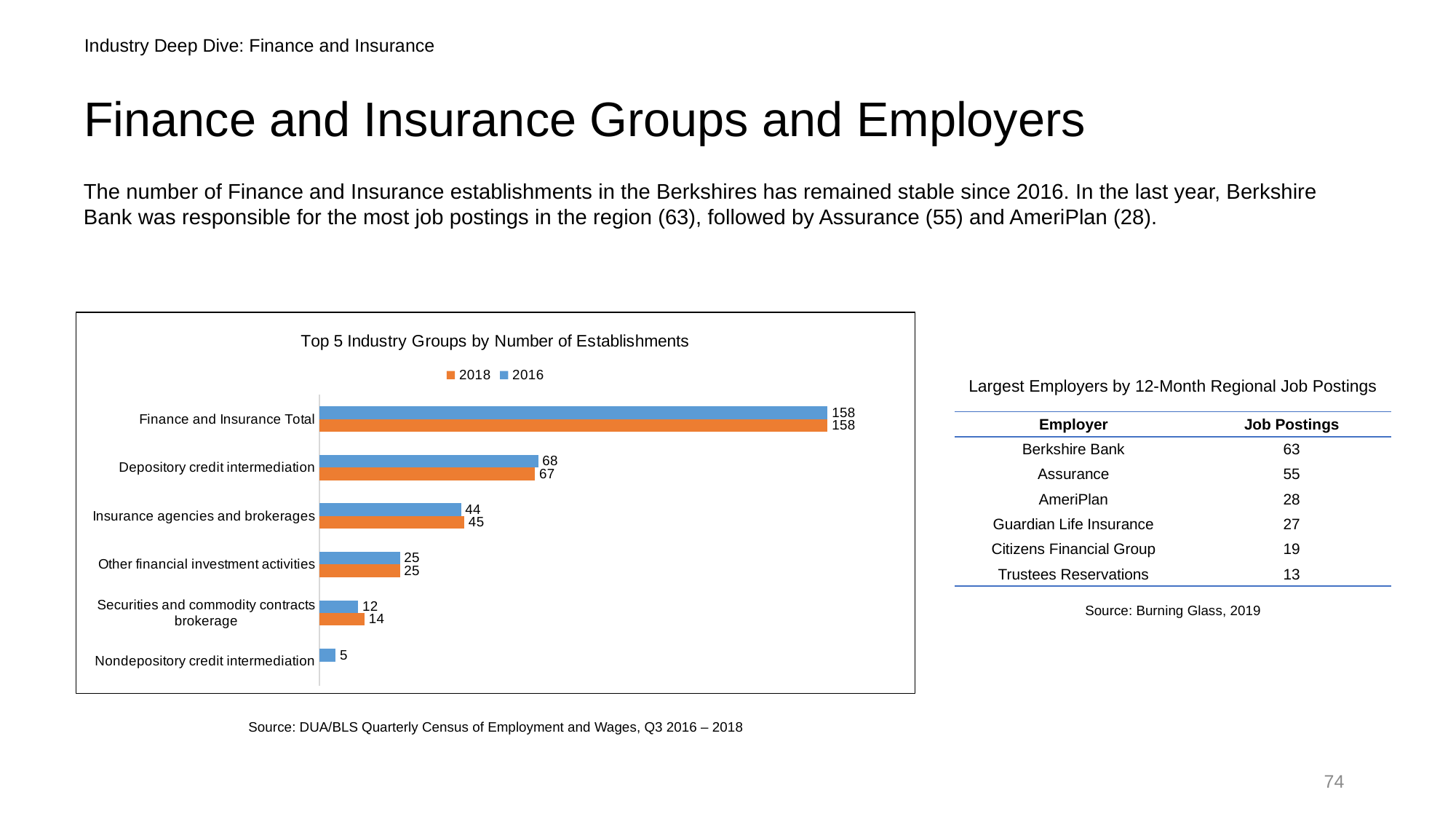
In the 'Top 5 Industry Groups by Number of Establishments' chart, what is the difference between the 2016 and 2018 values for Securities and commodity contracts brokerage? 2 In the 'Top 5 Industry Groups by Number of Establishments' chart, which category has the highest 2018 value? Finance and Insurance Total In the 'Top 5 Industry Groups by Number of Establishments' chart, what is the 2016 value for Nondepository credit intermediation? 5 In the 'Top 5 Industry Groups by Number of Establishments' chart, is the 2016 value for Depository credit intermediation larger or smaller than the 2016 value for Insurance agencies and brokerages? larger In the 'Top 5 Industry Groups by Number of Establishments' chart, what is the 2018 value for Insurance agencies and brokerages? 45 In the 'Top 5 Industry Groups by Number of Establishments' chart, which colour represents the 2018 series? orange In the 'Top 5 Industry Groups by Number of Establishments' chart, what is the 2016 value for Depository credit intermediation? 68 What type of chart is 'Top 5 Industry Groups by Number of Establishments'? bar chart In the 'Top 5 Industry Groups by Number of Establishments' chart, what is the difference between the 2018 values for Depository credit intermediation and Insurance agencies and brokerages? 22 How many series does the legend of the 'Top 5 Industry Groups by Number of Establishments' chart list? 2 In the 'Top 5 Industry Groups by Number of Establishments' chart, which category has the lowest 2016 value? Nondepository credit intermediation In the 'Top 5 Industry Groups by Number of Establishments' chart, what is the 2018 value for Securities and commodity contracts brokerage? 14